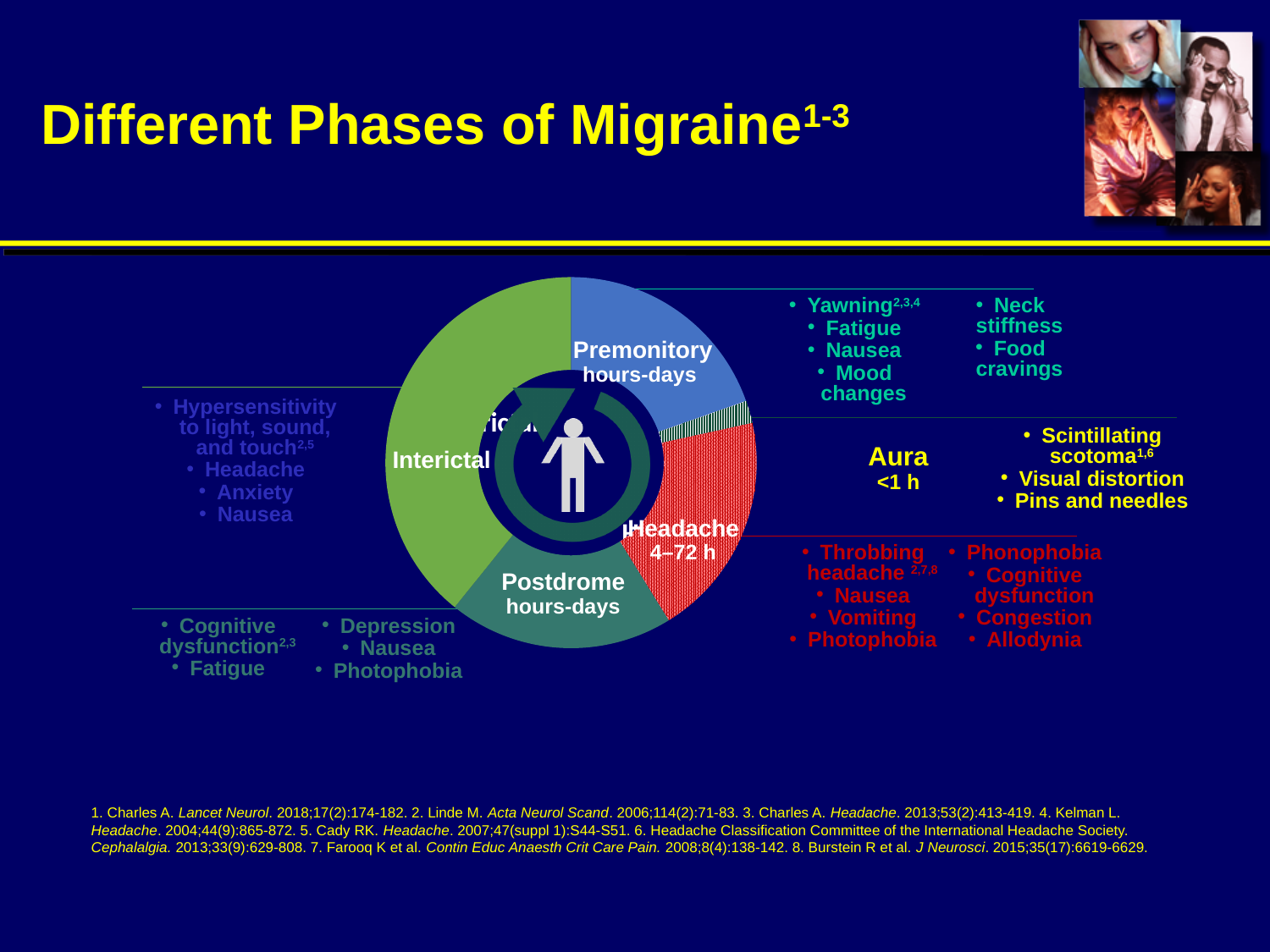
What duration is printed for the Aura phase? <1 h What duration is printed for the Premonitory phase? hours-days Which segment is larger in the diagram, Headache or Aura? Headache What duration is printed for the Postdrome phase? hours-days Which phase occupies the largest segment of the circular diagram? Interictal What is the title of the slide containing the phase diagram? Different Phases of Migraine What duration is printed for the Headache phase? 4–72 h What colour is the Interictal segment of the diagram? Green What kind of chart is used to show the phases of migraine? Pie (donut) chart How many phases (segments) are shown in the circular diagram? 5 Which phase occupies the smallest segment of the circular diagram? Aura